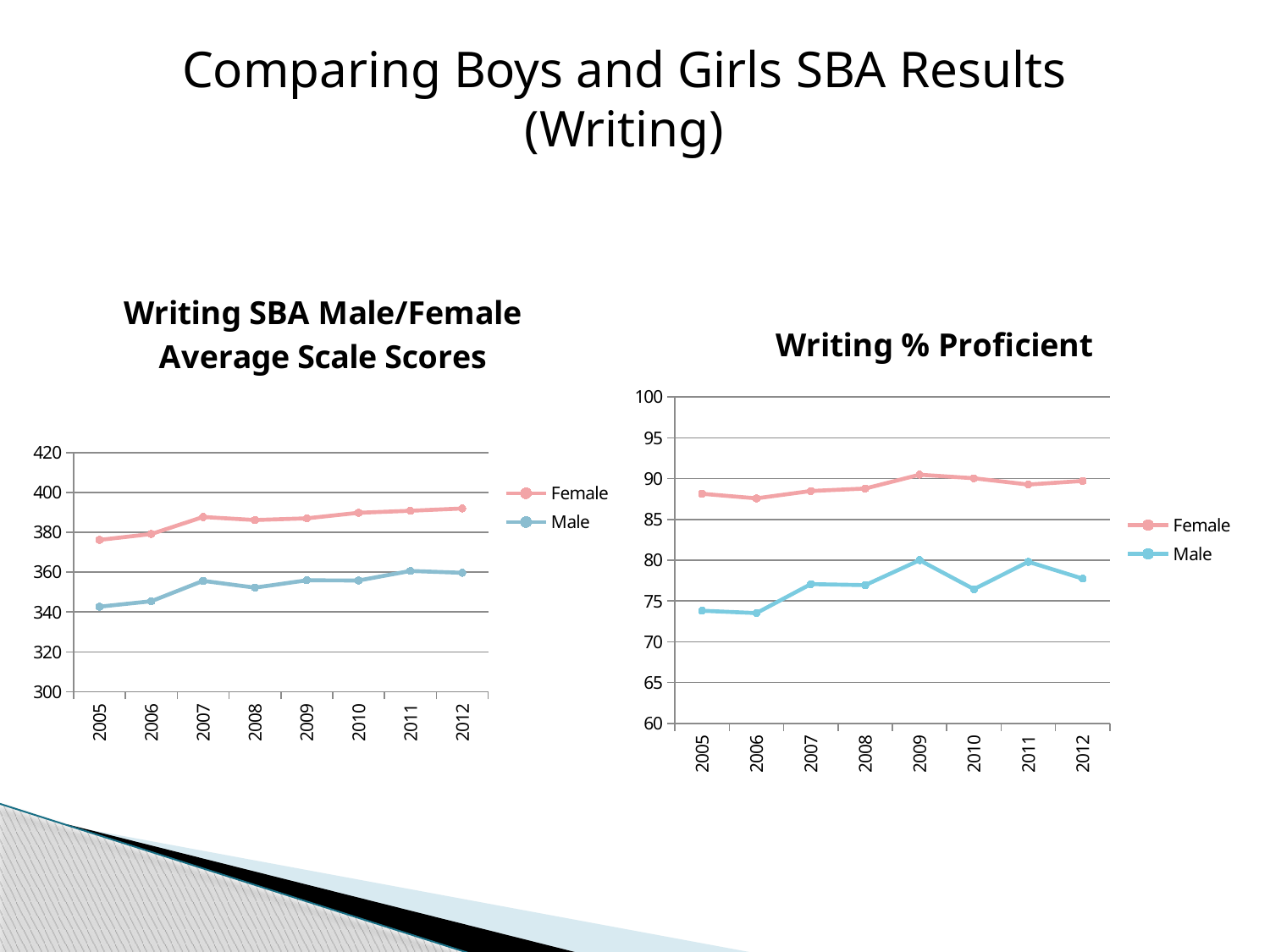
How many years are shown on the x axis of the "Writing SBA Male/Female Average Scale Scores" chart? 8 In the "Writing SBA Male/Female Average Scale Scores" chart, in which year is the Female series lowest? 2005 What colour is the Male series line in the "Writing % Proficient" chart? blue In the "Writing SBA Male/Female Average Scale Scores" chart, is the Female value for 2005 greater or less than 360? greater In the "Writing SBA Male/Female Average Scale Scores" chart, does the Female series generally rise or fall from 2005 to 2012? rise In the "Writing % Proficient" chart, is the Female value for 2005 greater or less than 85? greater In the "Writing SBA Male/Female Average Scale Scores" chart, which series has the higher value in 2012, Female or Male? Female In the "Writing SBA Male/Female Average Scale Scores" chart, is the Male value for 2005 greater or less than 360? less In the "Writing % Proficient" chart, which series has the higher value in 2010, Female or Male? Female How many series does the legend of the "Writing % Proficient" chart list? 2 What type of chart is the "Writing SBA Male/Female Average Scale Scores" chart? line chart